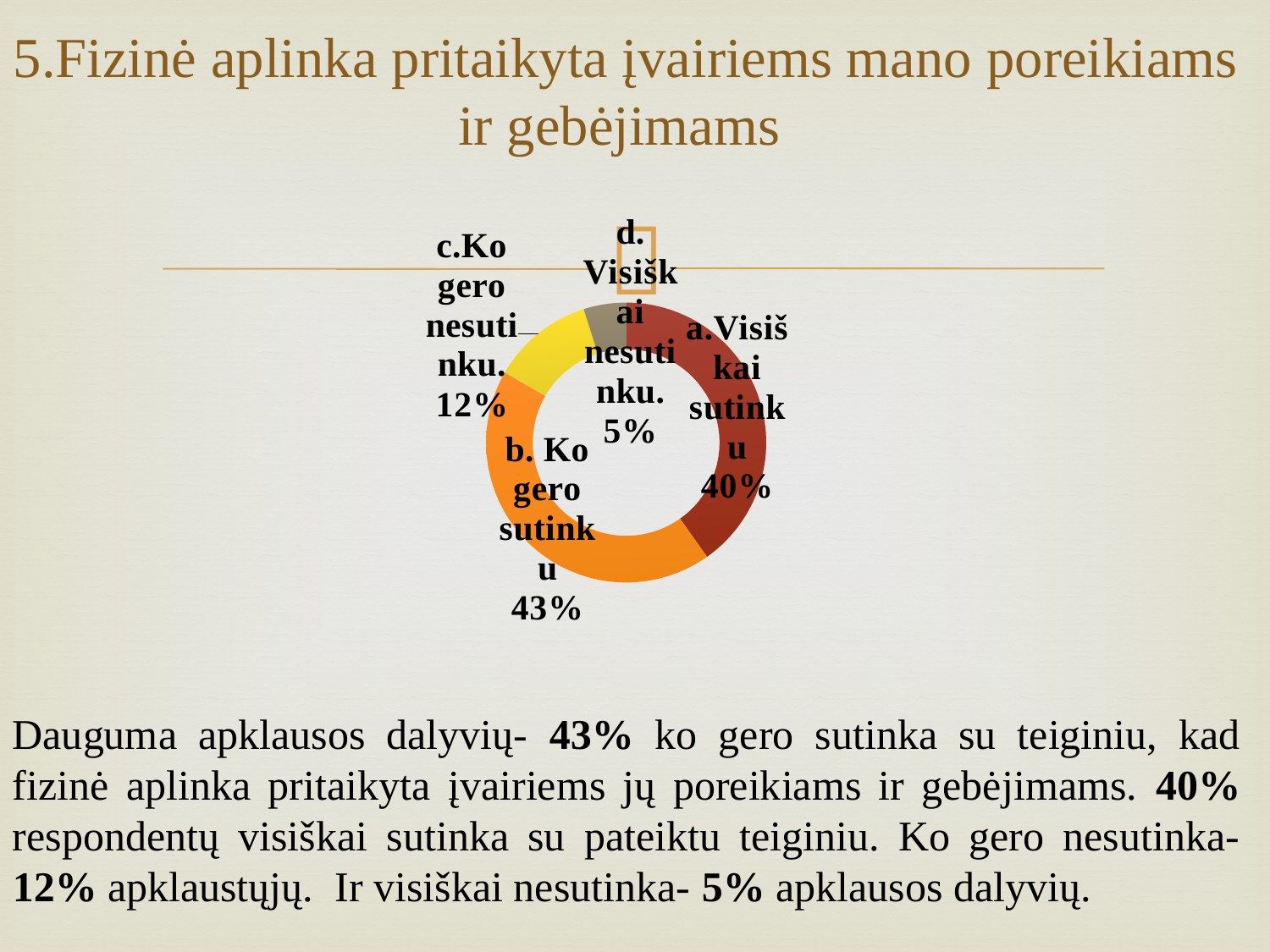
What is the difference in percentage points between "c. Ko gero nesutinku" and "d. Visiškai nesutinku"? 7 Which category has the smallest share of the chart? d. Visiškai nesutinku What percentage of respondents chose "a. Visiškai sutinku"? 40% What is the difference in percentage points between "b. Ko gero sutinku" and "a. Visiškai sutinku"? 3 Which is larger, the share for "c. Ko gero nesutinku" or the share for "d. Visiškai nesutinku"? c. Ko gero nesutinku How many categories are shown in the chart? 4 Which category has the largest share of the chart? b. Ko gero sutinku What is the combined share of "a. Visiškai sutinku" and "b. Ko gero sutinku"? 83% What percentage of respondents chose "b. Ko gero sutinku"? 43% What kind of chart is shown on the slide? Doughnut (pie) chart What percentage of respondents chose "c. Ko gero nesutinku"? 12% What percentage of respondents chose "d. Visiškai nesutinku"? 5%